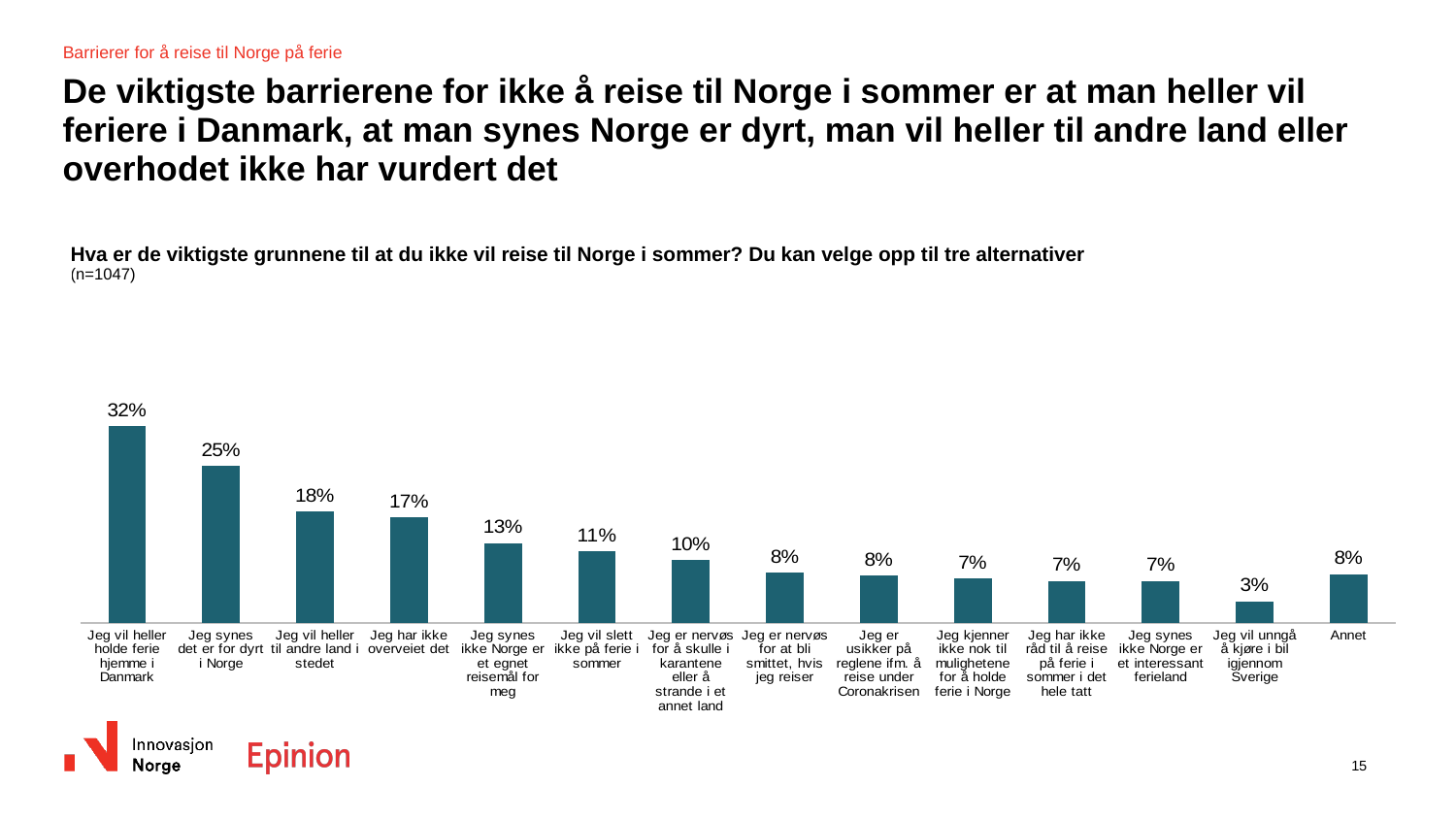
What is the value for "Jeg synes det er for dyrt i Norge"? 25% What is the value for "Jeg vil heller holde ferie hjemme i Danmark"? 32% What is the value for "Jeg har ikke overveiet det"? 17% What is the difference between the values for "Jeg vil slett ikke på ferie i sommer" and "Jeg vil unngå å kjøre i bil igjennom Sverige"? 8 percentage points What is the difference between the values for "Jeg vil heller holde ferie hjemme i Danmark" and "Jeg synes det er for dyrt i Norge"? 7 percentage points Which category has the lowest value? Jeg vil unngå å kjøre i bil igjennom Sverige What sample size (n) is stated for the survey question above the chart? n=1047 Which is larger: the value for "Jeg vil heller til andre land i stedet" or for "Jeg synes ikke Norge er et egnet reisemål for meg"? Jeg vil heller til andre land i stedet How many categories (bars) does the chart show? 14 Which category has the highest value? Jeg vil heller holde ferie hjemme i Danmark What is the value for "Annet"? 8% What kind of chart is shown on the slide? bar chart